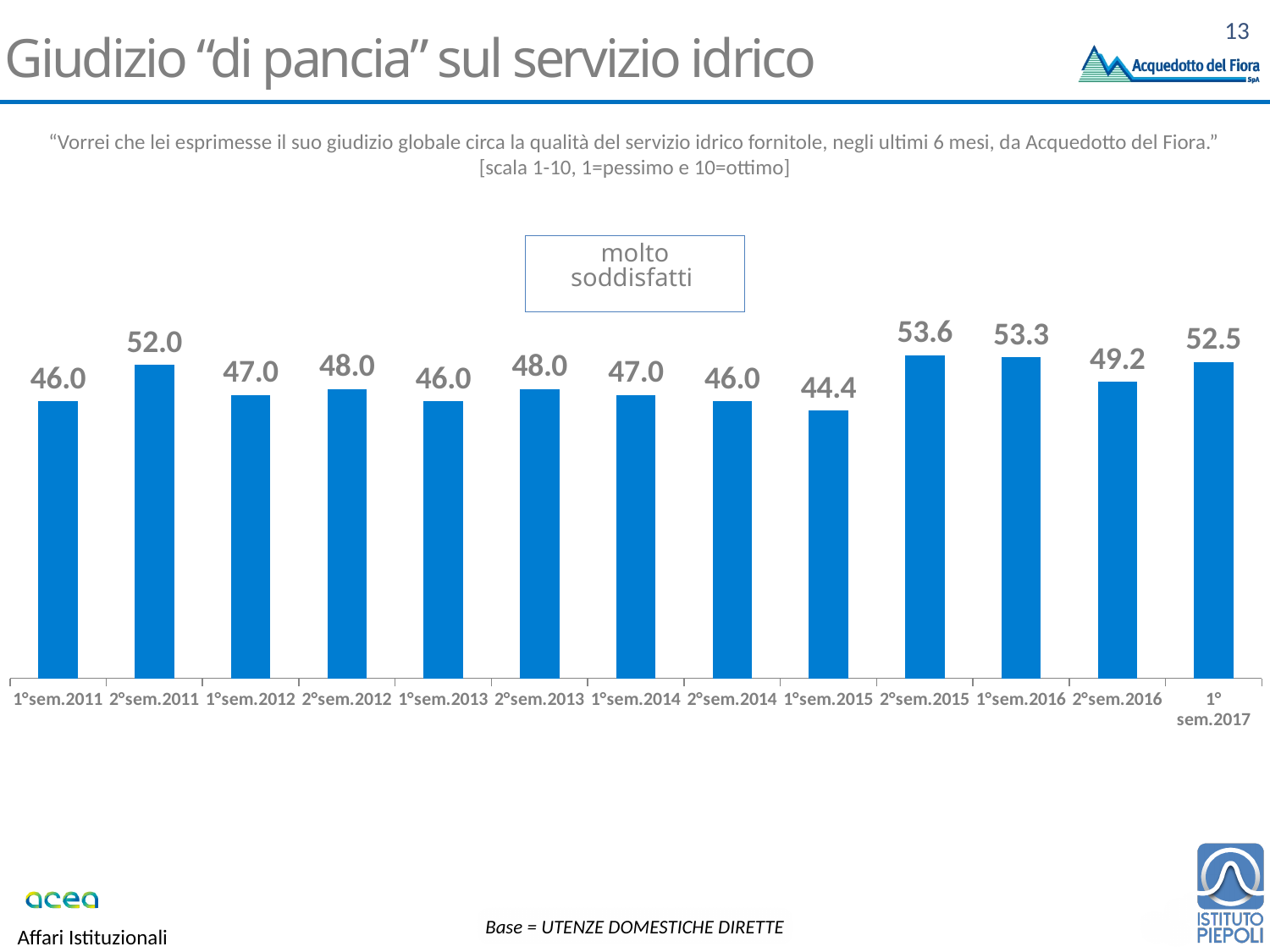
What is the difference between the values for 2°sem.2015 and 1°sem.2015? 9.2 What is the value for 1°sem.2017? 52.5 Do the values rise or fall from 1°sem.2015 to 2°sem.2015? rise What kind of chart is shown on the slide? bar chart Which period has the lowest value? 1°sem.2015 What is the value for 2°sem.2011? 52.0 Which is larger, the value for 2°sem.2016 or the value for 1°sem.2017? 1°sem.2017 What label appears in the box above the bars? molto soddisfatti What is the value for 1°sem.2015? 44.4 Which period has the highest value? 2°sem.2015 How many periods are shown on the x axis? 13 What is the difference between the values for 1°sem.2016 and 2°sem.2016? 4.1